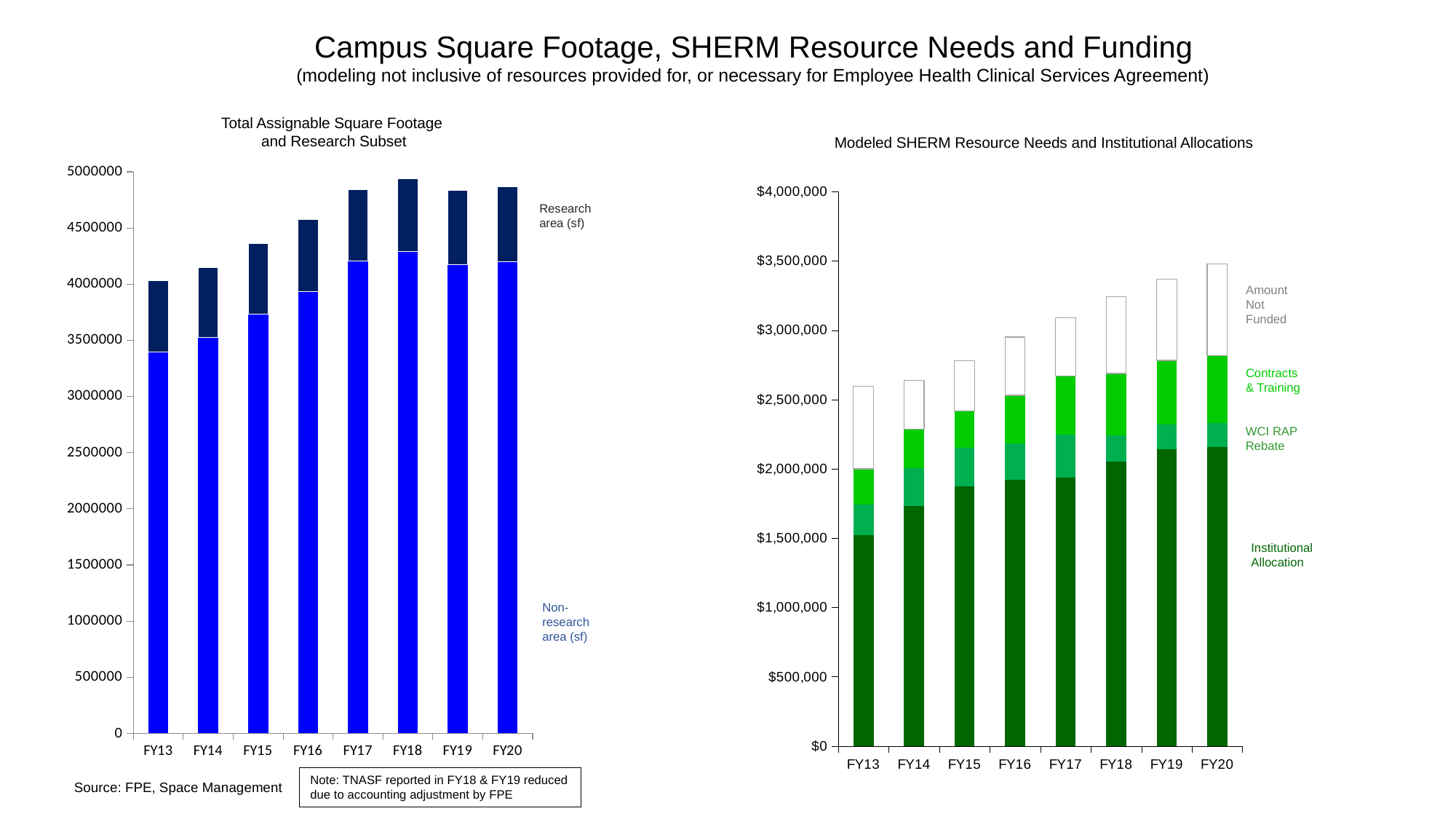
In the 'Modeled SHERM Resource Needs and Institutional Allocations' chart, which fiscal year has the highest total bar? FY20 What kind of chart is the 'Total Assignable Square Footage and Research Subset' chart? Stacked bar chart In the 'Modeled SHERM Resource Needs and Institutional Allocations' chart, which series is shown in dark green at the bottom of each bar? Institutional Allocation In the 'Total Assignable Square Footage and Research Subset' chart, which fiscal year has the highest total bar? FY18 In the 'Total Assignable Square Footage and Research Subset' chart, is the total bar for FY16 greater or less than 4500000? greater How many series does the 'Total Assignable Square Footage and Research Subset' chart show? 2 In the 'Modeled SHERM Resource Needs and Institutional Allocations' chart, is the Institutional Allocation value for FY20 greater or less than $2,000,000? greater In the 'Total Assignable Square Footage and Research Subset' chart, which fiscal year has the lowest total bar? FY13 In the 'Total Assignable Square Footage and Research Subset' chart, is the Non-research area (sf) value for FY13 greater or less than 3500000? less In the 'Modeled SHERM Resource Needs and Institutional Allocations' chart, does the Institutional Allocation rise or fall from FY13 to FY20? rise How many fiscal years are shown on the 'Modeled SHERM Resource Needs and Institutional Allocations' chart? 8 How many series does the 'Modeled SHERM Resource Needs and Institutional Allocations' chart show? 4